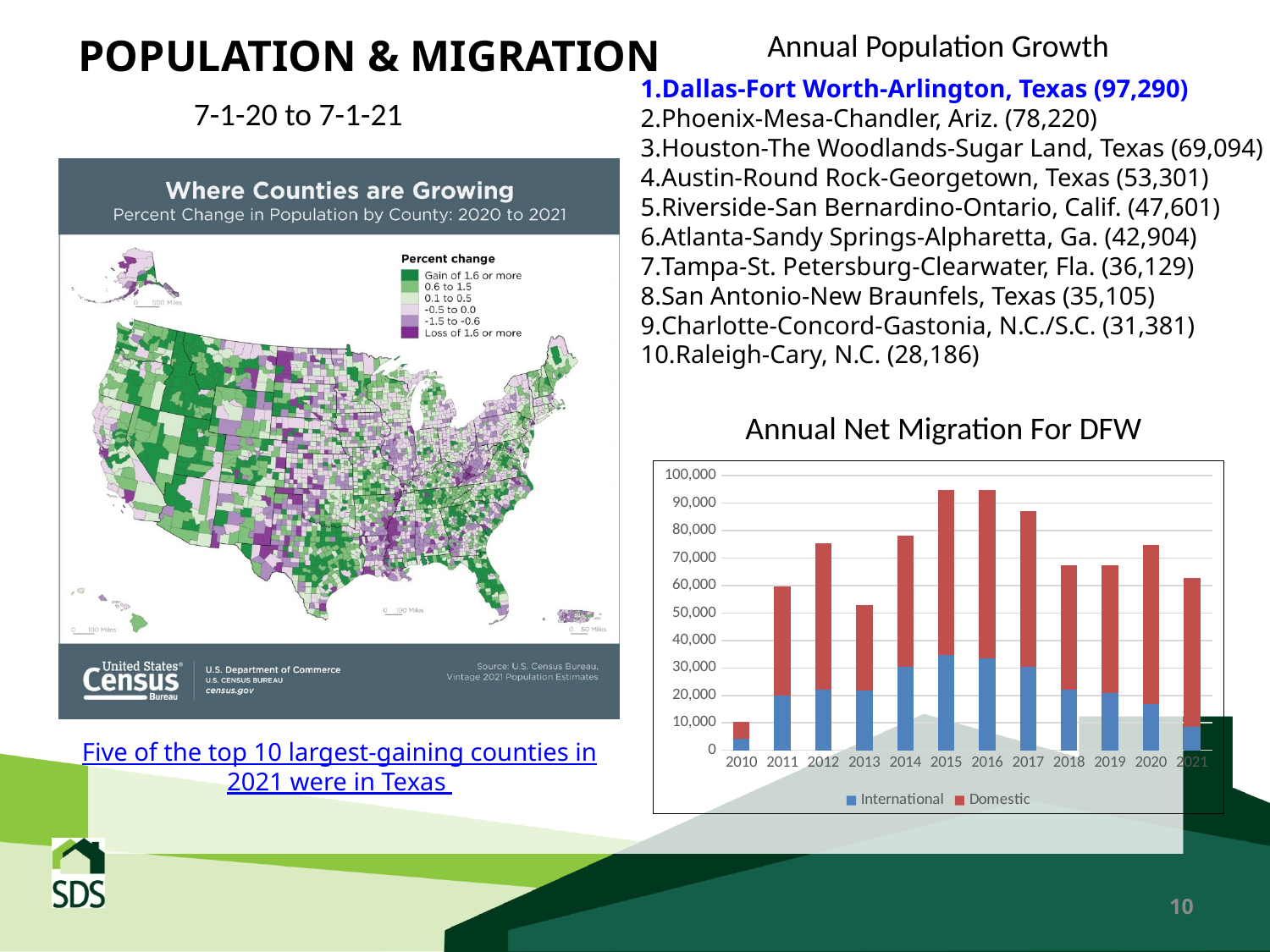
In the 'Annual Net Migration For DFW' chart, is the total bar for 2012 greater or less than 70,000? greater In the 'Annual Net Migration For DFW' chart, is the International value for 2015 greater or less than 30,000? greater How many series does the legend of the 'Annual Net Migration For DFW' chart list? 2 In the 'Annual Net Migration For DFW' chart, which series is shown in red? Domestic In the 'Annual Net Migration For DFW' chart, is the total bar for 2013 greater or less than 50,000? greater In the 'Annual Net Migration For DFW' chart, which year has the larger total net migration, 2012 or 2013? 2012 How many years are shown on the x axis of the 'Annual Net Migration For DFW' chart? 12 In the 'Annual Net Migration For DFW' chart, which year has the lowest total net migration? 2010 What kind of chart is the 'Annual Net Migration For DFW' chart? stacked bar chart In the 'Annual Net Migration For DFW' chart, do the total bars rise or fall from 2016 to 2018? fall